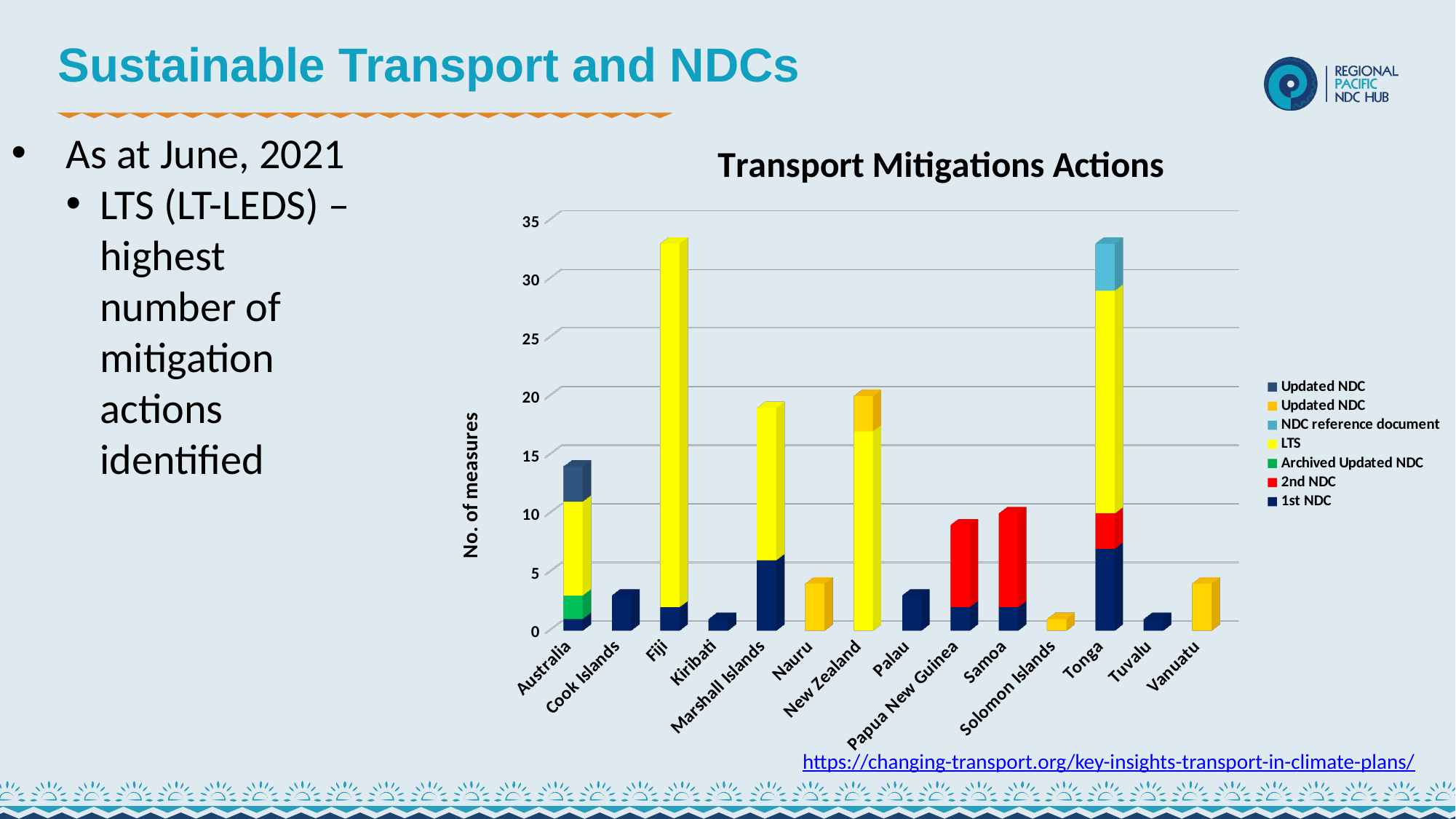
How many series does the chart legend list? 7 Is the total value for Australia greater or less than 10? greater Is the total value for Fiji greater or less than 30? greater What is the label of the vertical axis? No. of measures Is the total value for Cook Islands greater or less than 5? less How many countries are shown on the x axis of the chart? 14 What kind of chart is shown on the slide? Stacked bar chart What is the title of the chart? Transport Mitigations Actions Which has the larger total, Fiji or Australia? Fiji